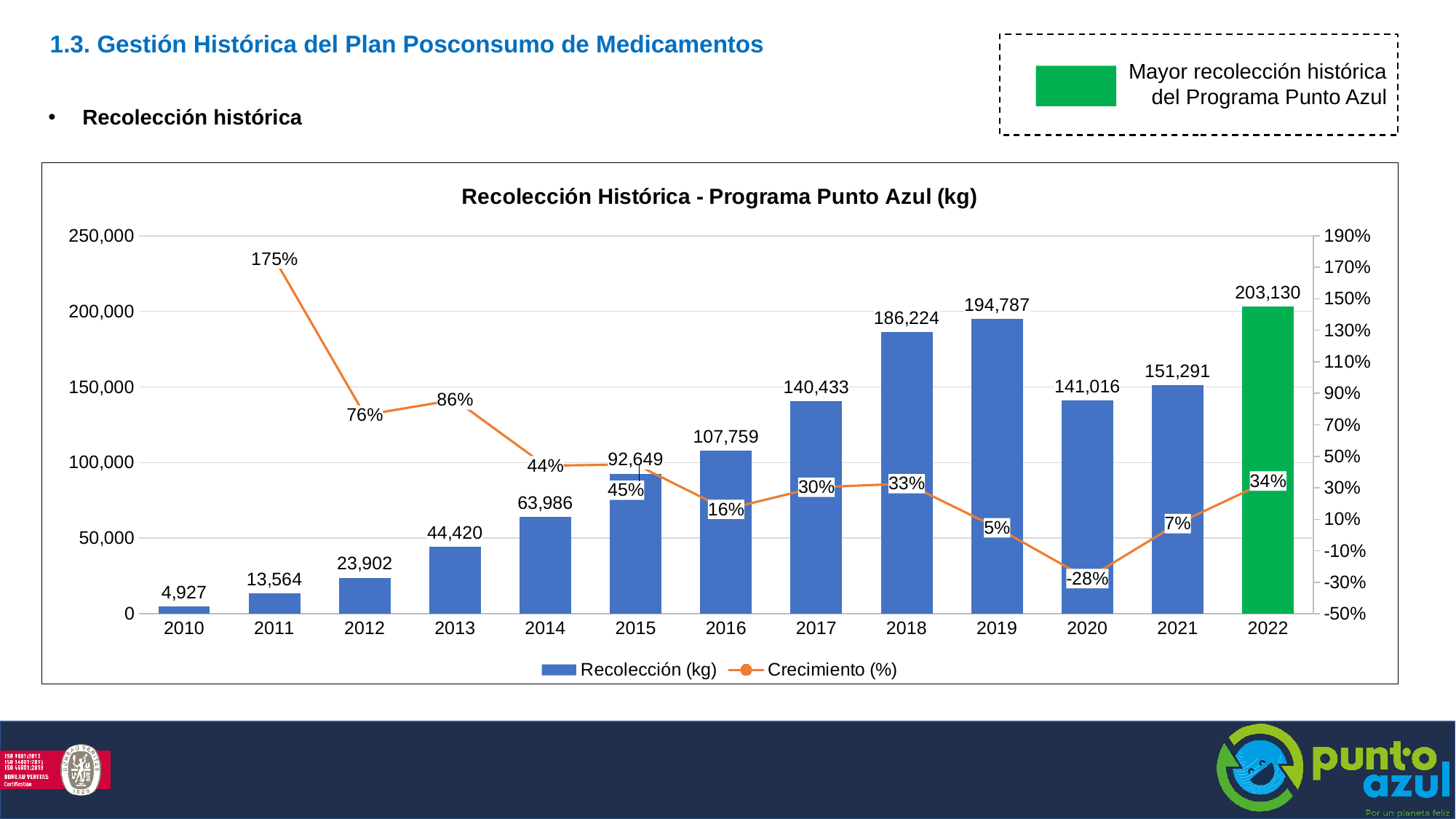
Which year has the highest Recolección (kg)? 2022 What is the difference in Recolección (kg) between 2022 and 2021? 51,839 How many series does the legend list? 2 Is the Recolección (kg) value for 2017 greater or less than 100,000? greater Which year has the lowest Recolección (kg)? 2010 What is the title of the chart? Recolección Histórica - Programa Punto Azul (kg) Which year has the lowest Crecimiento (%)? 2020 What is the Recolección (kg) value for 2018? 186,224 Which year has a larger Recolección (kg), 2019 or 2020? 2019 How many years are shown on the x axis? 13 What kind of chart is used for the Recolección (kg) series? bar chart What is the Crecimiento (%) value for 2011? 175%